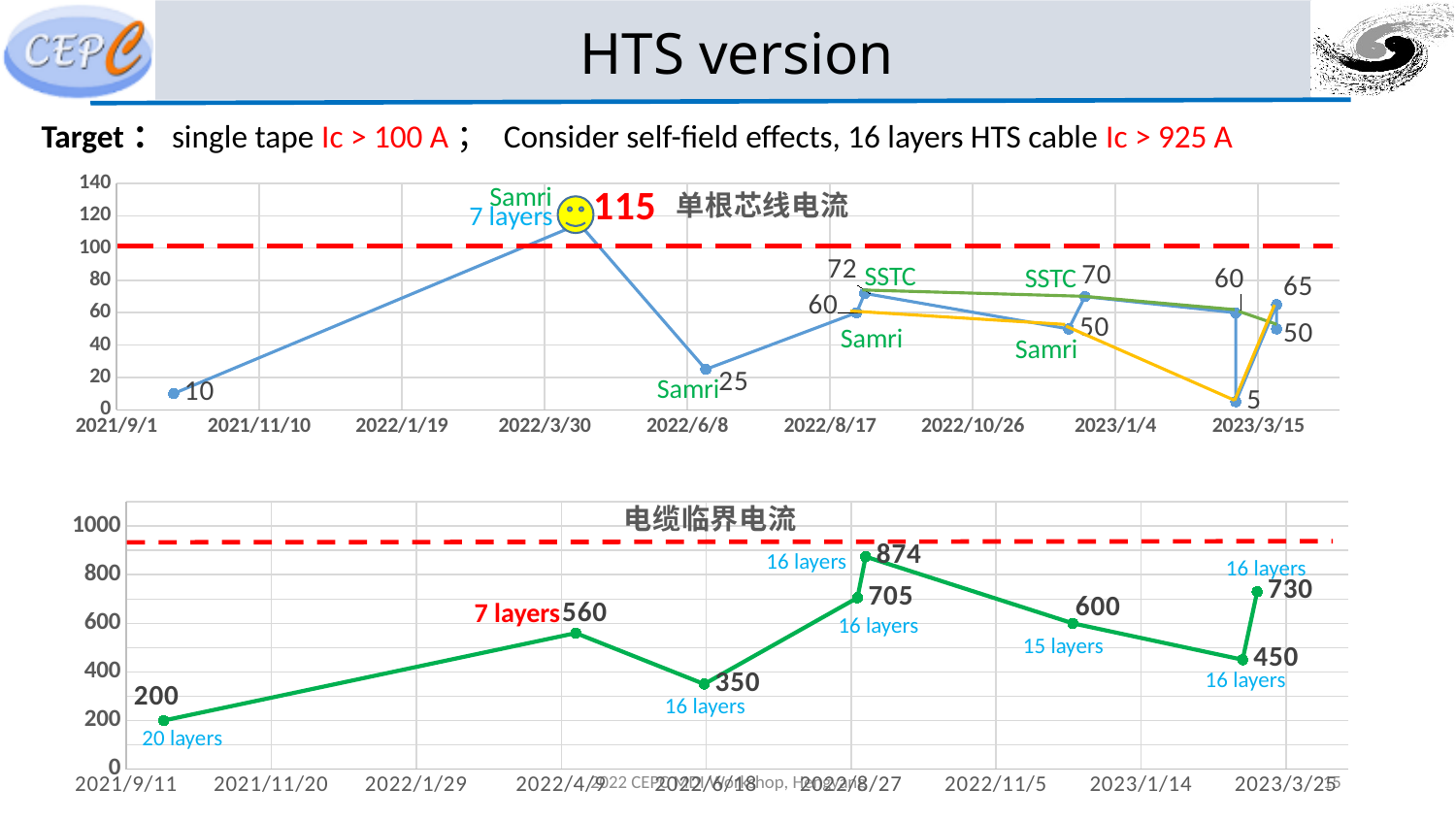
What is the title of the top chart? 单根芯线电流 In the top chart (单根芯线电流), what is the highest plotted value? 115 How many data points are plotted in the bottom chart (电缆临界电流)? 8 In the top chart (单根芯线电流), is the Samri 7 layers value greater or less than 100? greater In the bottom chart (电缆临界电流), which is larger: the point labelled 600 (15 layers) or the point labelled 450 (16 layers)? 600 In the bottom chart (电缆临界电流), what is the difference between the 874 point and the 705 point? 169 In the bottom chart (电缆临界电流), what value is labelled '7 layers'? 560 In the bottom chart (电缆临界电流), what value is labelled '20 layers'? 200 In the bottom chart (电缆临界电流), what is the highest plotted value? 874 In the top chart (单根芯线电流), what is the lowest plotted value? 5 In the bottom chart (电缆临界电流), what is the lowest plotted value? 200 What kind of chart is the bottom chart titled 电缆临界电流? line chart